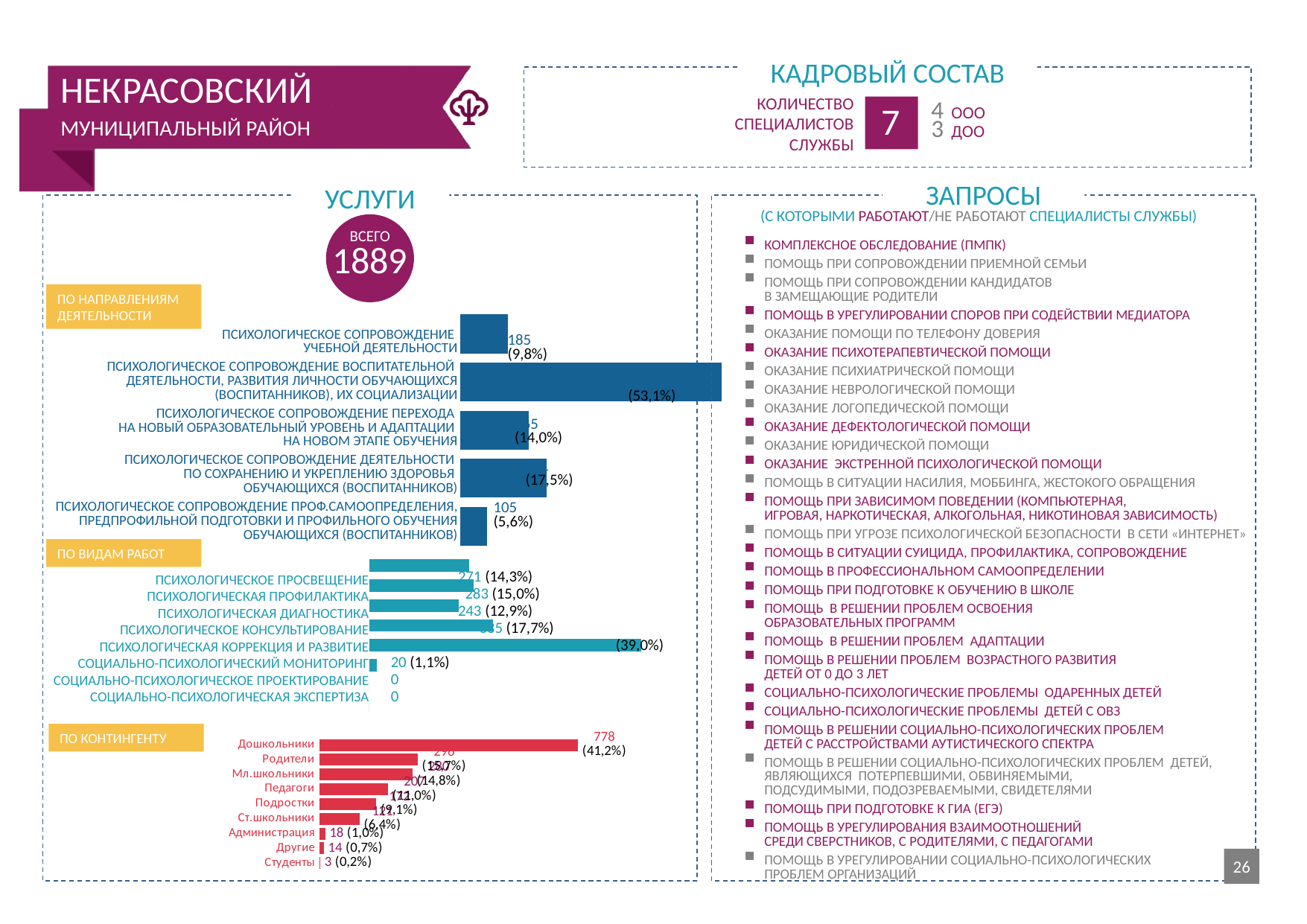
In the 'По видам работ' chart, what is the value for 'Социально-психологический мониторинг'? 20 In the 'По контингенту' chart, what is the difference between the values for 'Администрация' and 'Другие'? 4 In the 'По видам работ' chart, which is larger: 'Психологическая профилактика' or 'Психологическое просвещение'? Психологическая профилактика In the 'По контингенту' chart, which category has the lowest value? Студенты In the 'По направлениям деятельности' chart, what is the value for 'Психологическое сопровождение учебной деятельности'? 185 In the 'По направлениям деятельности' chart, which category has the highest value? Психологическое сопровождение воспитательной деятельности, развития личности обучающихся (воспитанников), их социализации In the 'По контингенту' chart, what is the value for 'Дошкольники'? 778 What type of chart is the 'По контингенту' chart? Bar chart How many categories are shown in the 'По видам работ' chart? 8 In the 'По видам работ' chart, what is the value for 'Психологическая профилактика'? 283 In the 'По направлениям деятельности' chart, what percentage is shown for 'Психологическое сопровождение проф.самоопределения, предпрофильной подготовки и профильного обучения обучающихся (воспитанников)'? 5,6% In the 'По видам работ' chart, which category has the highest value? Психологическая коррекция и развитие